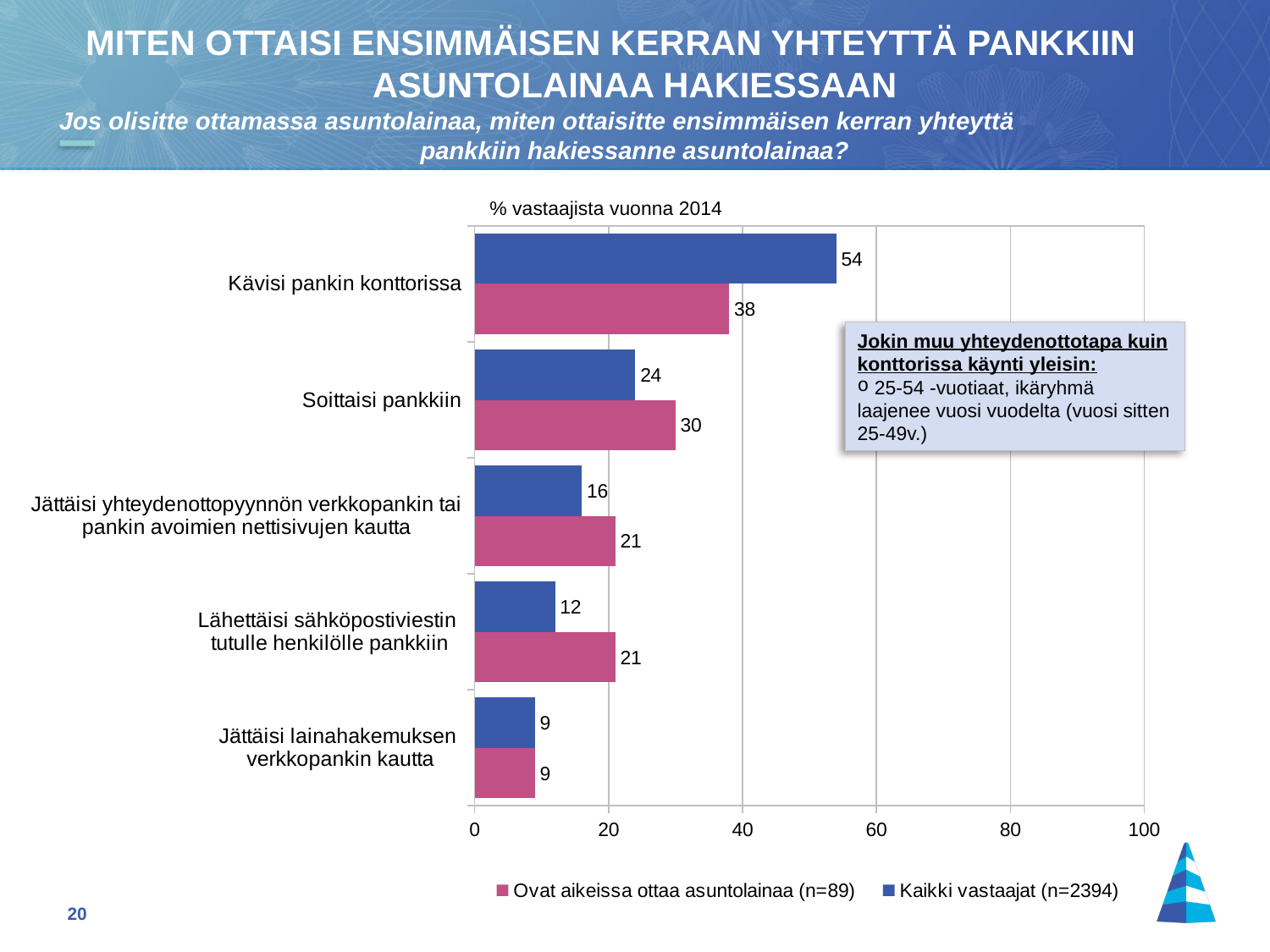
For 'Soittaisi pankkiin', which series has the larger value: 'Kaikki vastaajat (n=2394)' or 'Ovat aikeissa ottaa asuntolainaa (n=89)'? Ovat aikeissa ottaa asuntolainaa (n=89) Which category has the highest value in the 'Kaikki vastaajat (n=2394)' series? Kävisi pankin konttorissa What is the value for 'Soittaisi pankkiin' in the 'Ovat aikeissa ottaa asuntolainaa (n=89)' series? 30 What is the title shown above the chart? % vastaajista vuonna 2014 How many series does the legend list? 2 How many categories are shown in the chart? 5 What is the value for 'Kävisi pankin konttorissa' in the 'Kaikki vastaajat (n=2394)' series? 54 What is the value for 'Lähettäisi sähköpostiviestin tutulle henkilölle pankkiin' in the 'Kaikki vastaajat (n=2394)' series? 12 What is the difference between the 'Kaikki vastaajat (n=2394)' and 'Ovat aikeissa ottaa asuntolainaa (n=89)' values for 'Kävisi pankin konttorissa'? 16 Which category has the lowest value in the 'Ovat aikeissa ottaa asuntolainaa (n=89)' series? Jättäisi lainahakemuksen verkkopankin kautta Is the value for 'Kävisi pankin konttorissa' in the 'Kaikki vastaajat (n=2394)' series greater or less than 40? greater What kind of chart is shown on the slide? bar chart